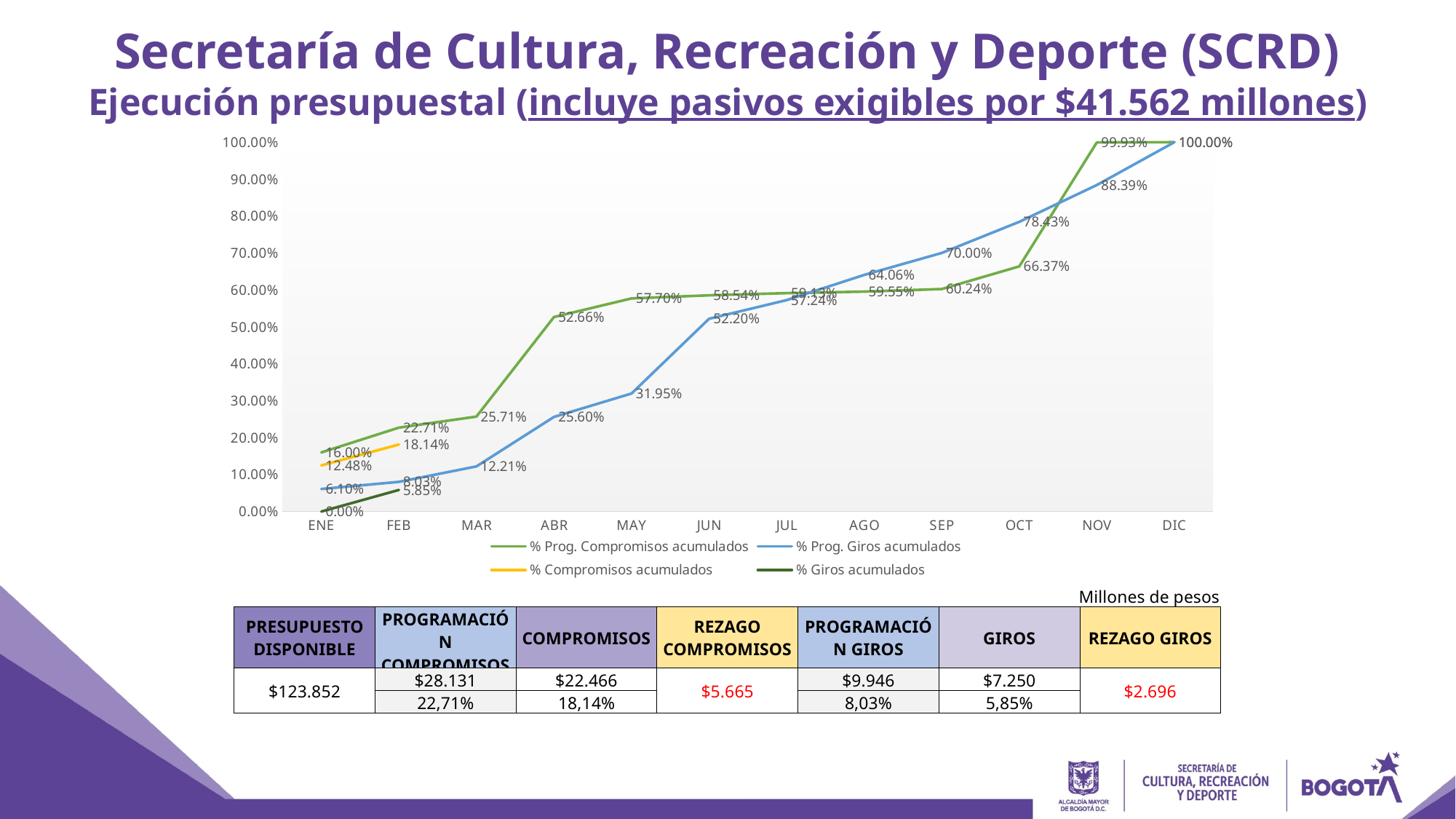
What is the value of % Prog. Giros acumulados in NOV? 88.39% How many series does the chart legend list? 4 What is the difference between % Prog. Compromisos acumulados and % Prog. Giros acumulados in MAY? 25.75% What is the value of % Compromisos acumulados in FEB? 18.14% In which month is % Prog. Giros acumulados lowest? ENE How many months are shown on the x axis of the chart? 12 What type of chart is shown on the slide? line chart Does % Prog. Giros acumulados rise or fall from ENE to DIC? rise What is the value of % Giros acumulados in ENE? 0.00% Which is larger in SEP: % Prog. Compromisos acumulados or % Prog. Giros acumulados? % Prog. Giros acumulados What is the value of % Prog. Compromisos acumulados in ABR? 52.66% Which series is drawn in yellow in the chart? % Compromisos acumulados